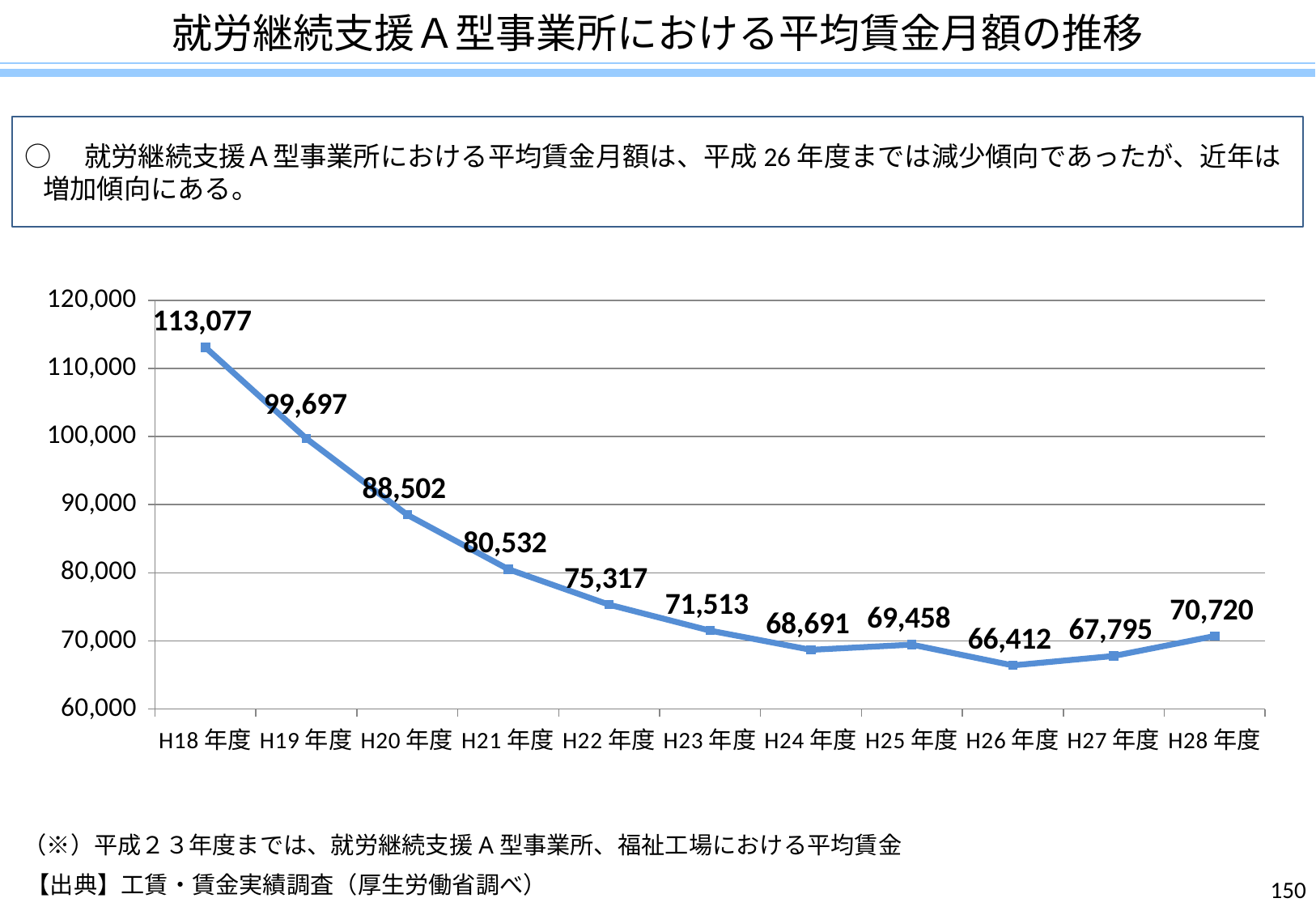
What is the value for H18年度? 113,077 What is the value for H26年度? 66,412 What is the difference between the values for H18年度 and H28年度? 42,357 Which fiscal year has the highest value? H18年度 Do the values rise or fall from H18年度 to H24年度? Fall What is the value for H28年度? 70,720 What is the difference between the values for H28年度 and H27年度? 2,925 What is the value for H22年度? 75,317 Which fiscal year has the lowest value? H26年度 How many fiscal years are plotted on the chart? 11 Which is larger, the value for H24年度 or H25年度? H25年度 What type of chart is shown on the slide? Line chart